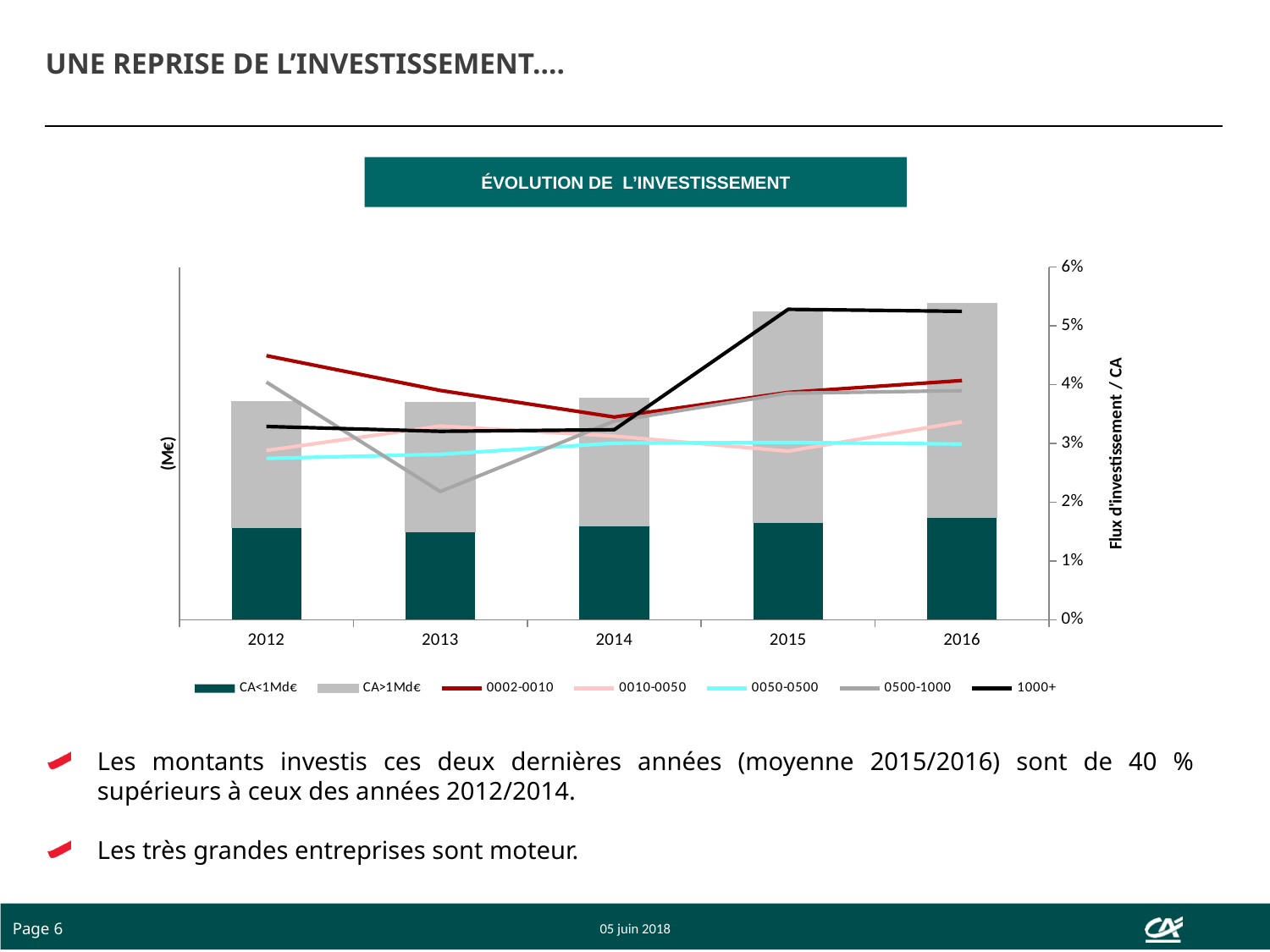
How many years are shown on the x axis of the chart? 5 Is the value of the 0500-1000 line in 2013 greater or less than 3%? less What kind of chart is shown on the slide? Combined bar and line chart In which year is the 0002-0010 line at its highest? 2012 What is the title of the chart? ÉVOLUTION DE L'INVESTISSEMENT Is the value of the 1000+ line in 2015 greater or less than 5%? greater Is the value of the 1000+ line in 2012 greater or less than 4%? less What is the label of the right-hand axis of the chart? Flux d'investissement / CA How many series does the chart legend list? 7 In 2015, which line is higher: 1000+ or 0002-0010? 1000+ In which year is the 0500-1000 line at its lowest? 2013